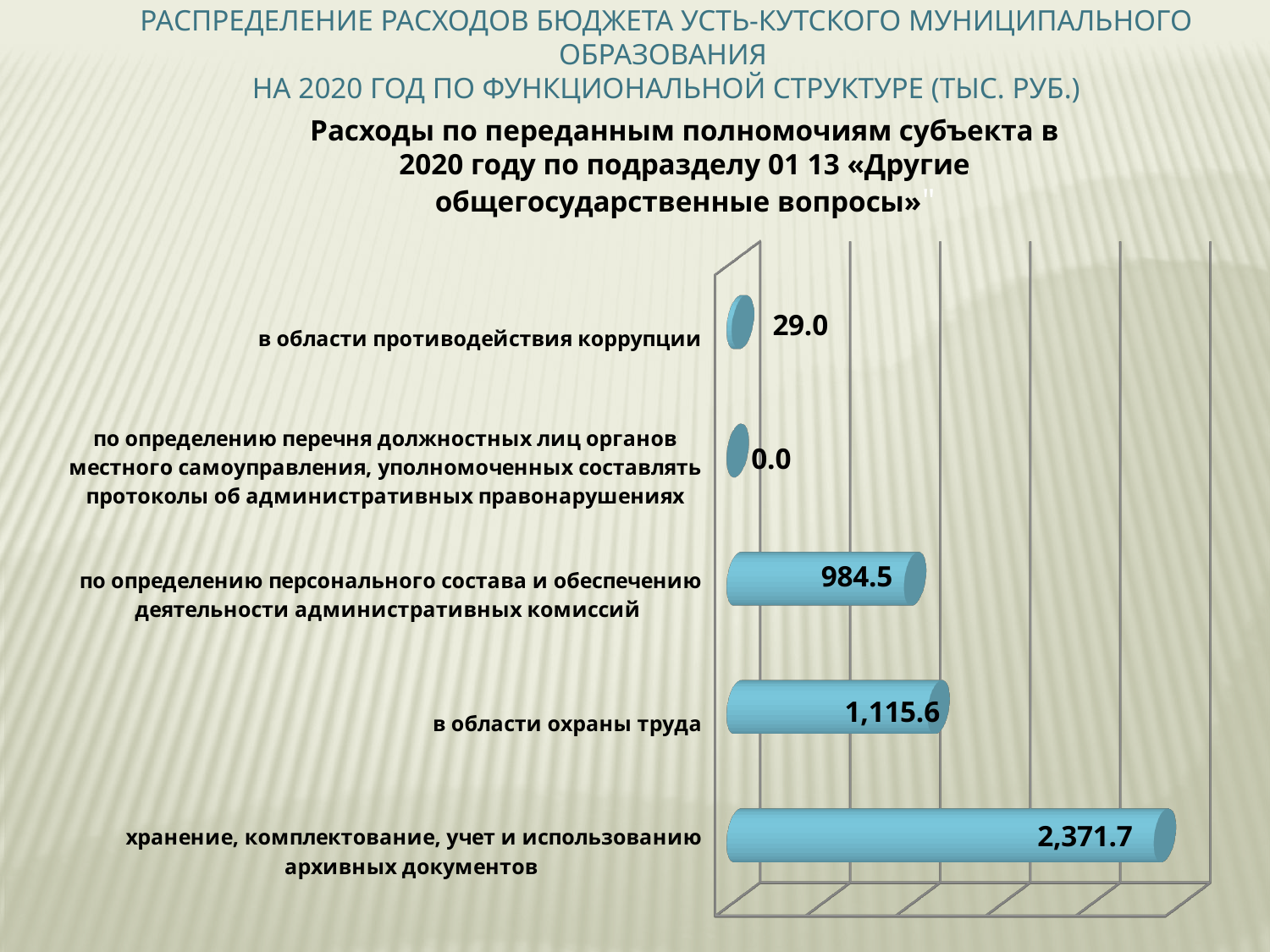
What kind of chart is shown on the slide? bar chart What is the difference between the values for «хранение, комплектование, учет и использованию архивных документов» and «в области охраны труда»? 1,256.1 What is the value for «в области охраны труда»? 1,115.6 How many categories are shown in the chart? 5 What is the value for «по определению перечня должностных лиц органов местного самоуправления, уполномоченных составлять протоколы об административных правонарушениях»? 0.0 What is the value for «по определению персонального состава и обеспечению деятельности административных комиссий»? 984.5 What is the value for «в области противодействия коррупции»? 29.0 Which is larger: the value for «в области охраны труда» or for «по определению персонального состава и обеспечению деятельности административных комиссий»? в области охраны труда Which category has the highest value? хранение, комплектование, учет и использованию архивных документов What is the difference between the values for «в области охраны труда» and «по определению персонального состава и обеспечению деятельности административных комиссий»? 131.1 Which category has the lowest value? по определению перечня должностных лиц органов местного самоуправления, уполномоченных составлять протоколы об административных правонарушениях What is the value for «хранение, комплектование, учет и использованию архивных документов»? 2,371.7